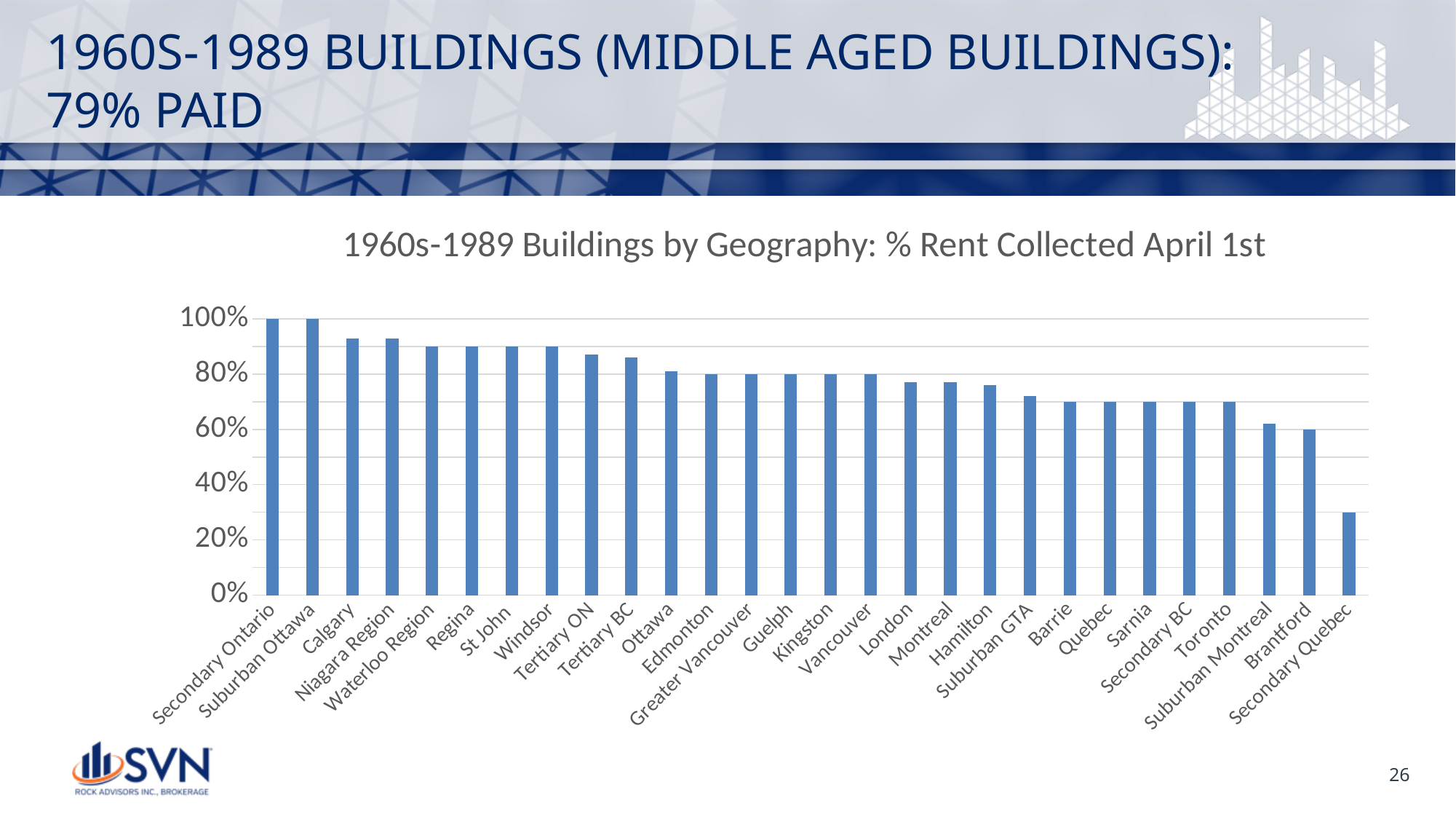
Do the values generally rise or fall moving from left to right along the x axis? Fall Is the value for Tertiary ON greater or less than 80%? greater What is the title of the chart? 1960s-1989 Buildings by Geography: % Rent Collected April 1st Is the value for Calgary greater or less than 80%? greater Which geography has the lowest % rent collected? Secondary Quebec Is the value for Secondary Quebec greater or less than 40%? less What is the % rent collected for Secondary Ontario? 100% How many geographies are plotted in the chart? 28 What is the % rent collected for Brantford? 60% What kind of chart is shown on the slide? Bar chart Which has a higher % rent collected, Calgary or Toronto? Calgary